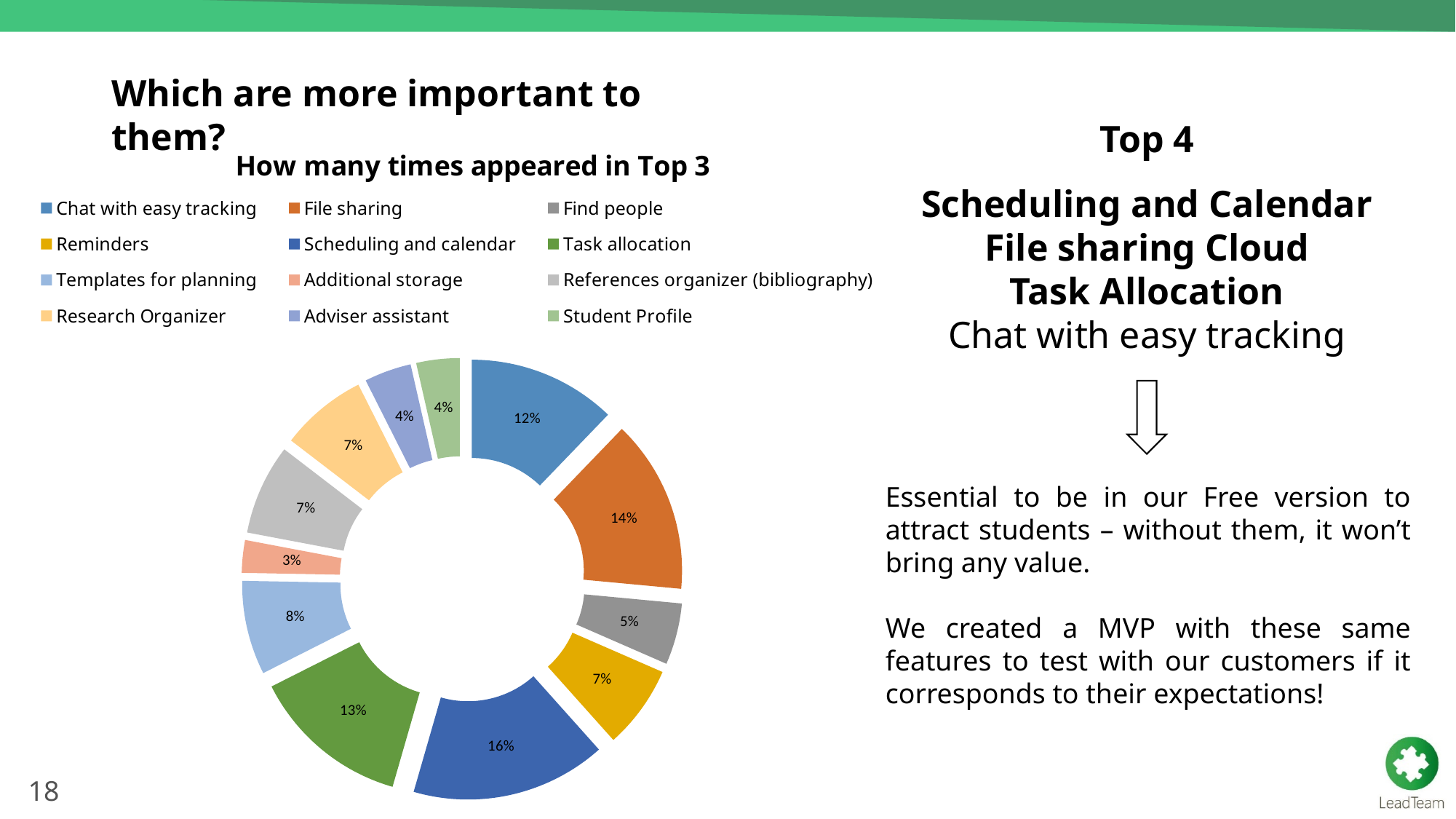
Which category has the smallest slice in the chart? Additional storage What percentage does the Scheduling and calendar slice show? 16% What percentage does the Templates for planning slice show? 8% What percentage does the Additional storage slice show? 3% What kind of chart is shown on the slide? doughnut chart Which category has the largest slice in the chart? Scheduling and calendar Which is larger, the slice for Chat with easy tracking or the slice for Task allocation? Task allocation What is the title of the chart? How many times appeared in Top 3 How many categories are shown in the chart? 12 What percentage does the File sharing slice show? 14% What is the difference in percentage points between Scheduling and calendar and Task allocation? 3 What share of the chart does Find people represent? 5%